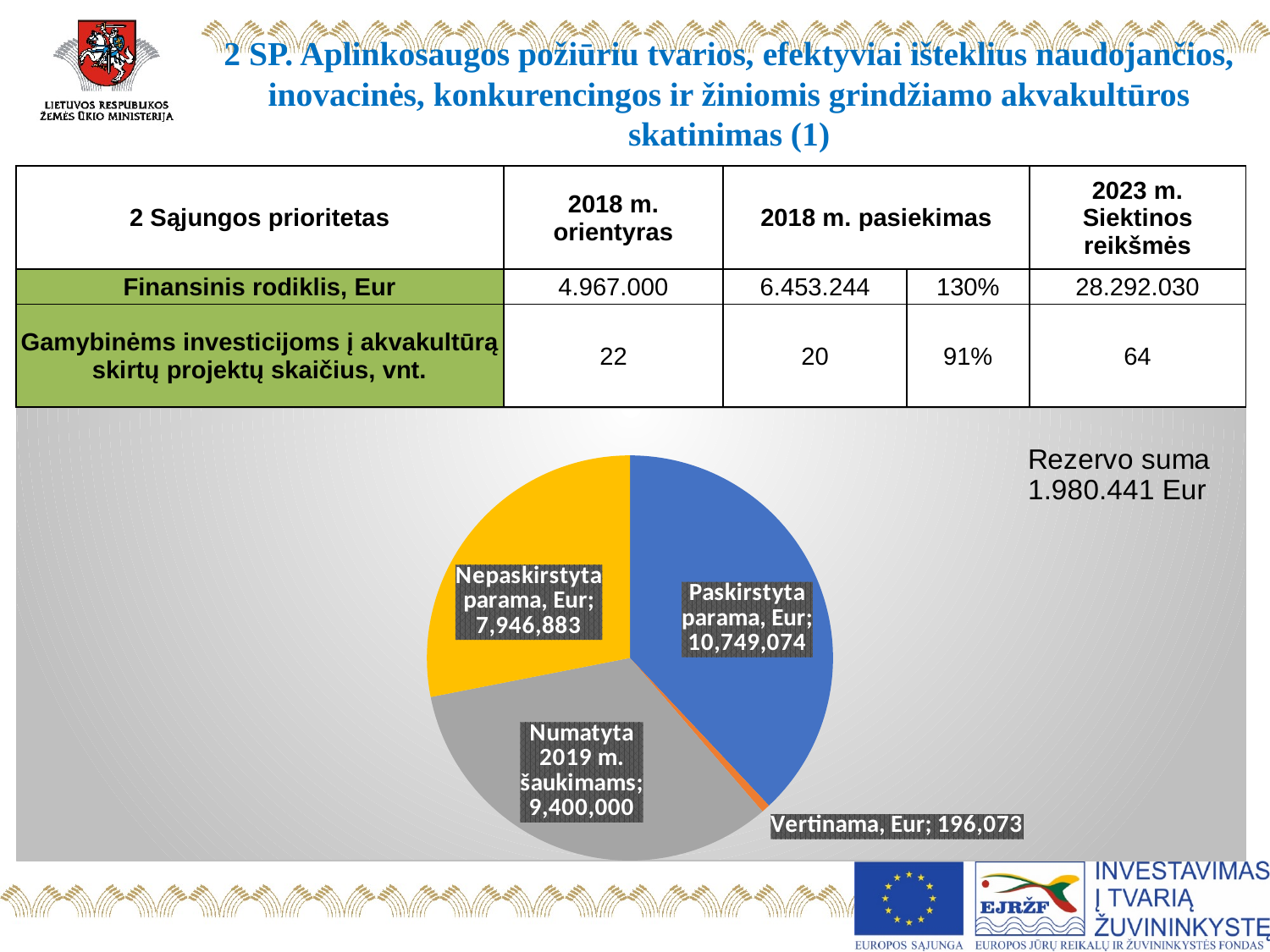
Which slice of the pie chart has the largest value? Paskirstyta parama, Eur What is the value of the 'Vertinama, Eur' slice in the pie chart? 196,073 How many slices does the pie chart have? 4 What is the value of the 'Numatyta 2019 m. šaukimams' slice in the pie chart? 9,400,000 What is the difference between the 'Paskirstyta parama, Eur' and 'Numatyta 2019 m. šaukimams' values in the pie chart? 1,349,074 What type of chart is shown on the slide? Pie chart What colour is the 'Paskirstyta parama, Eur' slice in the pie chart? Blue In the pie chart, which is larger: 'Numatyta 2019 m. šaukimams' or 'Nepaskirstyta parama, Eur'? Numatyta 2019 m. šaukimams What is the value of the 'Paskirstyta parama, Eur' slice in the pie chart? 10,749,074 Which slice of the pie chart has the smallest value? Vertinama, Eur What is the difference between the 'Numatyta 2019 m. šaukimams' and 'Nepaskirstyta parama, Eur' values in the pie chart? 1,453,117 What is the value of the 'Nepaskirstyta parama, Eur' slice in the pie chart? 7,946,883